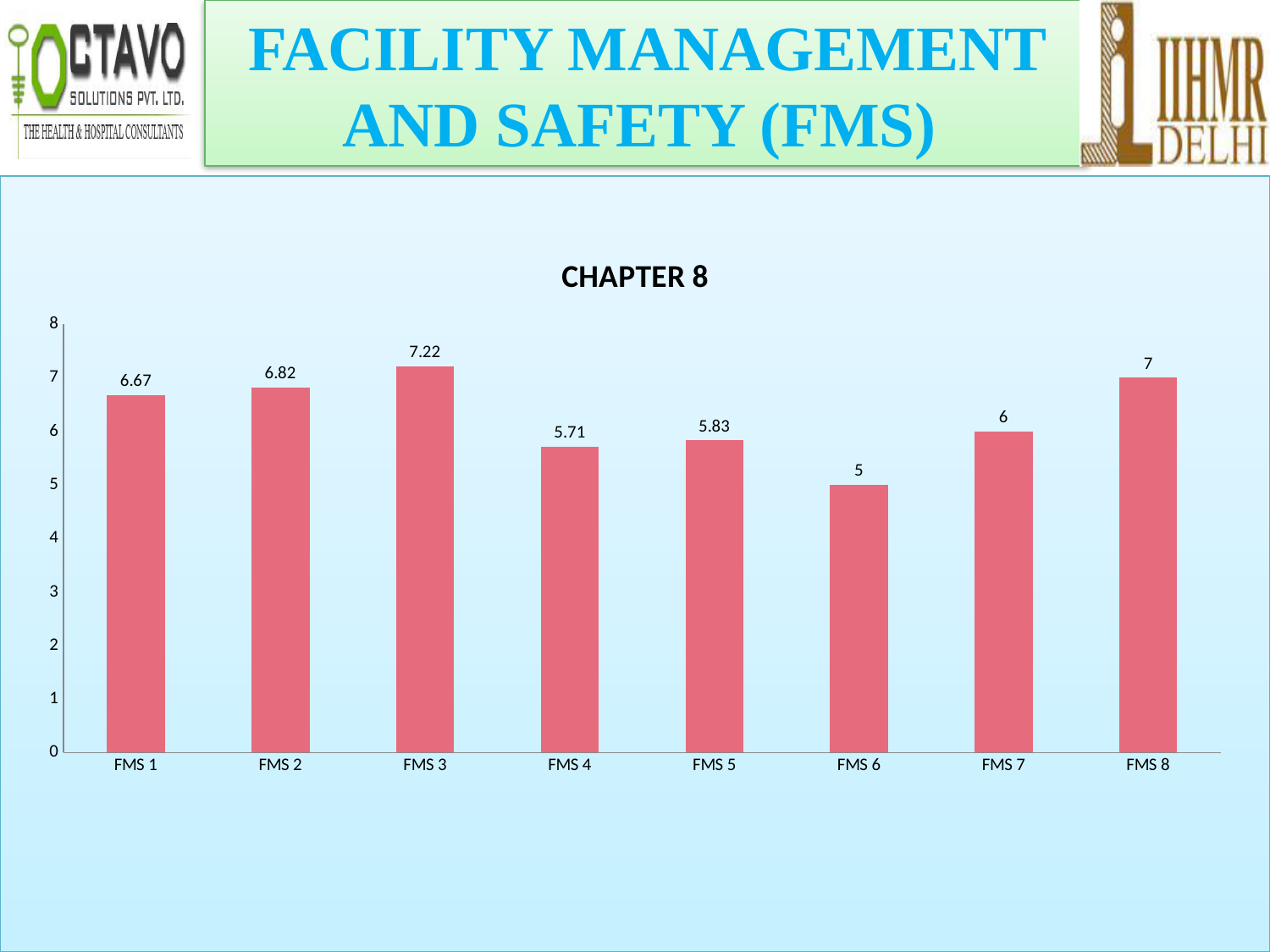
What is the value for FMS 6? 5 Which category has the lowest value? FMS 6 What is the value for FMS 8? 7 What is the title of the chart? CHAPTER 8 How many categories are shown on the x axis? 8 Is the value for FMS 4 greater or less than 6? less Which category has the highest value? FMS 3 Which is larger, the value for FMS 2 or the value for FMS 5? FMS 2 What is the value for FMS 1? 6.67 What kind of chart is shown on the slide? bar chart What is the value for FMS 3? 7.22 What is the difference between the values for FMS 3 and FMS 6? 2.22